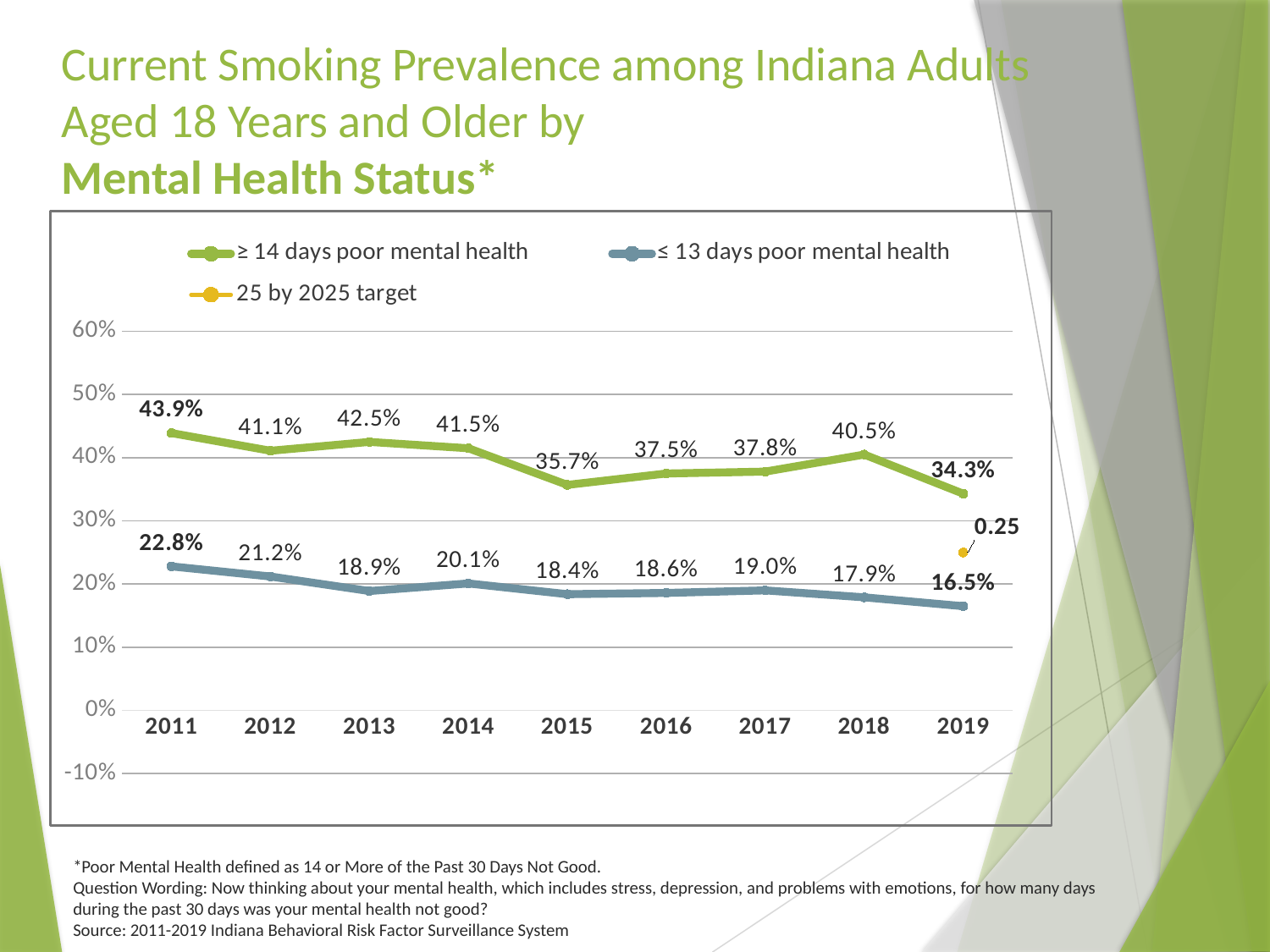
How many series does the legend list? 3 Which is larger in 2018: the ≥ 14 days poor mental health value or the ≤ 13 days poor mental health value? ≥ 14 days poor mental health How many years are shown on the x axis? 9 What kind of chart is shown on the slide? line chart In which year is the ≥ 14 days poor mental health series highest? 2011 Is the value for the ≥ 14 days poor mental health series in 2019 greater or less than 30%? greater In which year is the ≤ 13 days poor mental health series lowest? 2019 What is the value for the ≤ 13 days poor mental health series in 2019? 16.5% Does the ≤ 13 days poor mental health series generally rise or fall from 2011 to 2019? fall What is the difference between the ≥ 14 days and ≤ 13 days poor mental health values in 2019? 17.8% What is the value for the ≥ 14 days poor mental health series in 2011? 43.9% What is the value for the ≥ 14 days poor mental health series in 2015? 35.7%